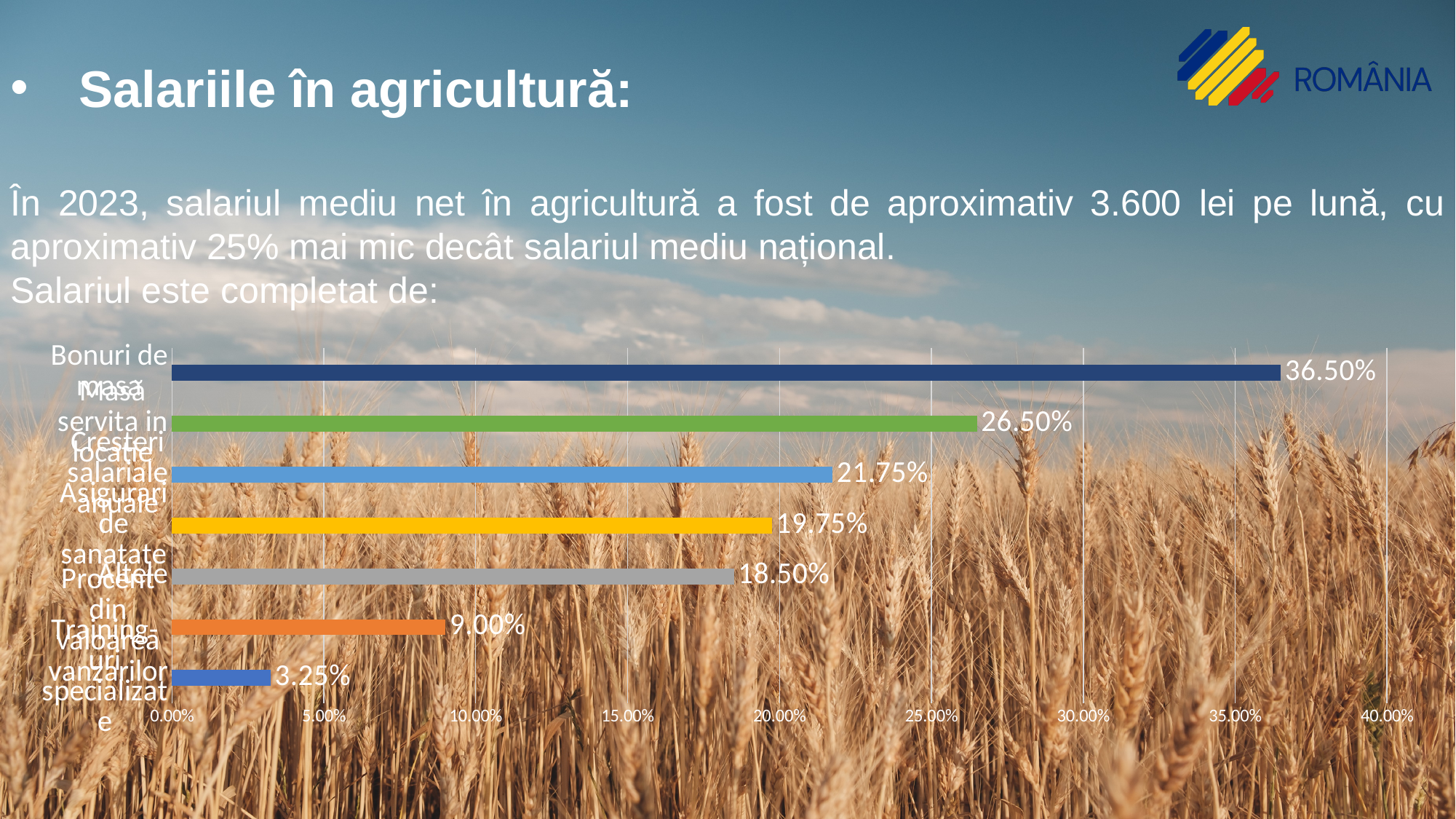
What is the value of the 'Altele' bar? 18.50% What kind of chart is shown on the slide? bar chart Which category has the highest value? Bonuri de masa What is the maximum value shown on the horizontal axis? 40.00% Which is larger, the value of the light blue bar or the value of the grey bar? the light blue bar (21.75%) What is the difference between the highest value (36.50%) and the lowest value (3.25%)? 33.25% What is the difference between the green bar (26.50%) and the yellow bar (19.75%)? 6.75% What is the value of the bottom bar, 'Training-uri specializate'? 3.25% What is the value of the orange bar? 9.00% What is the value of the top bar, 'Bonuri de masa'? 36.50% Which category has the lowest value? Training-uri specializate How many bars does the chart contain? 7